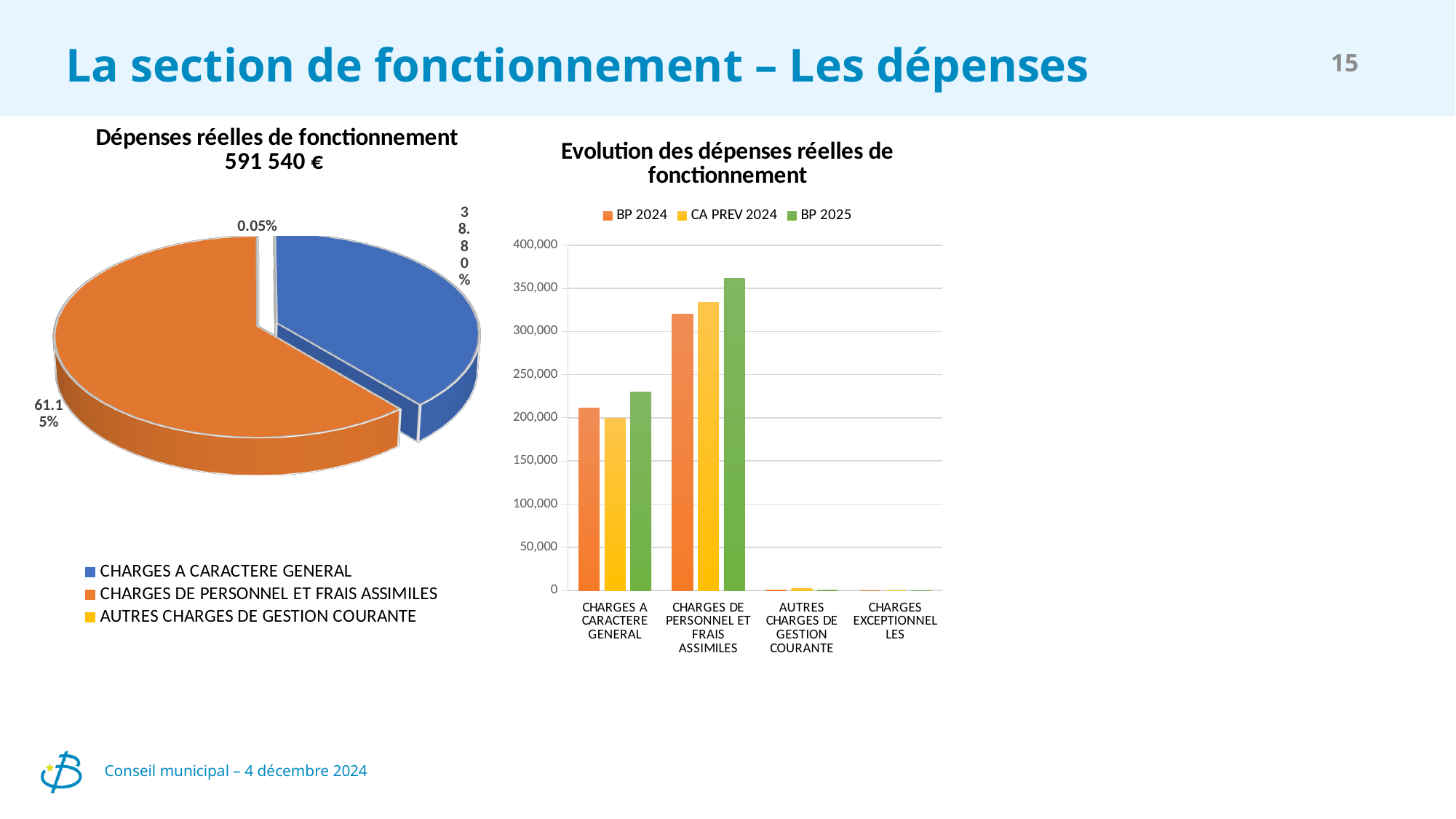
In the pie chart 'Dépenses réelles de fonctionnement', which category has the smallest slice? AUTRES CHARGES DE GESTION COURANTE What total amount is shown in the title of the pie chart on the left? 591 540 € How many categories are shown on the x axis of the chart 'Evolution des dépenses réelles de fonctionnement'? 4 In the chart 'Evolution des dépenses réelles de fonctionnement', is the BP 2025 value for CHARGES DE PERSONNEL ET FRAIS ASSIMILES greater or less than 350,000? greater How many series does the legend of the chart 'Evolution des dépenses réelles de fonctionnement' list? 3 In the pie chart 'Dépenses réelles de fonctionnement', what share is shown for CHARGES A CARACTERE GENERAL? 38.80% In the pie chart 'Dépenses réelles de fonctionnement', what share is shown for CHARGES DE PERSONNEL ET FRAIS ASSIMILES? 61.15% In the pie chart 'Dépenses réelles de fonctionnement', what share is shown for AUTRES CHARGES DE GESTION COURANTE? 0.05% In the pie chart 'Dépenses réelles de fonctionnement', what is the difference in percentage points between the CHARGES DE PERSONNEL ET FRAIS ASSIMILES slice and the CHARGES A CARACTERE GENERAL slice? 22.35 percentage points In the pie chart 'Dépenses réelles de fonctionnement', which category has the largest slice? CHARGES DE PERSONNEL ET FRAIS ASSIMILES What kind of chart is 'Evolution des dépenses réelles de fonctionnement'? Bar chart In the chart 'Evolution des dépenses réelles de fonctionnement', which is larger for CHARGES A CARACTERE GENERAL: BP 2024 or BP 2025? BP 2025